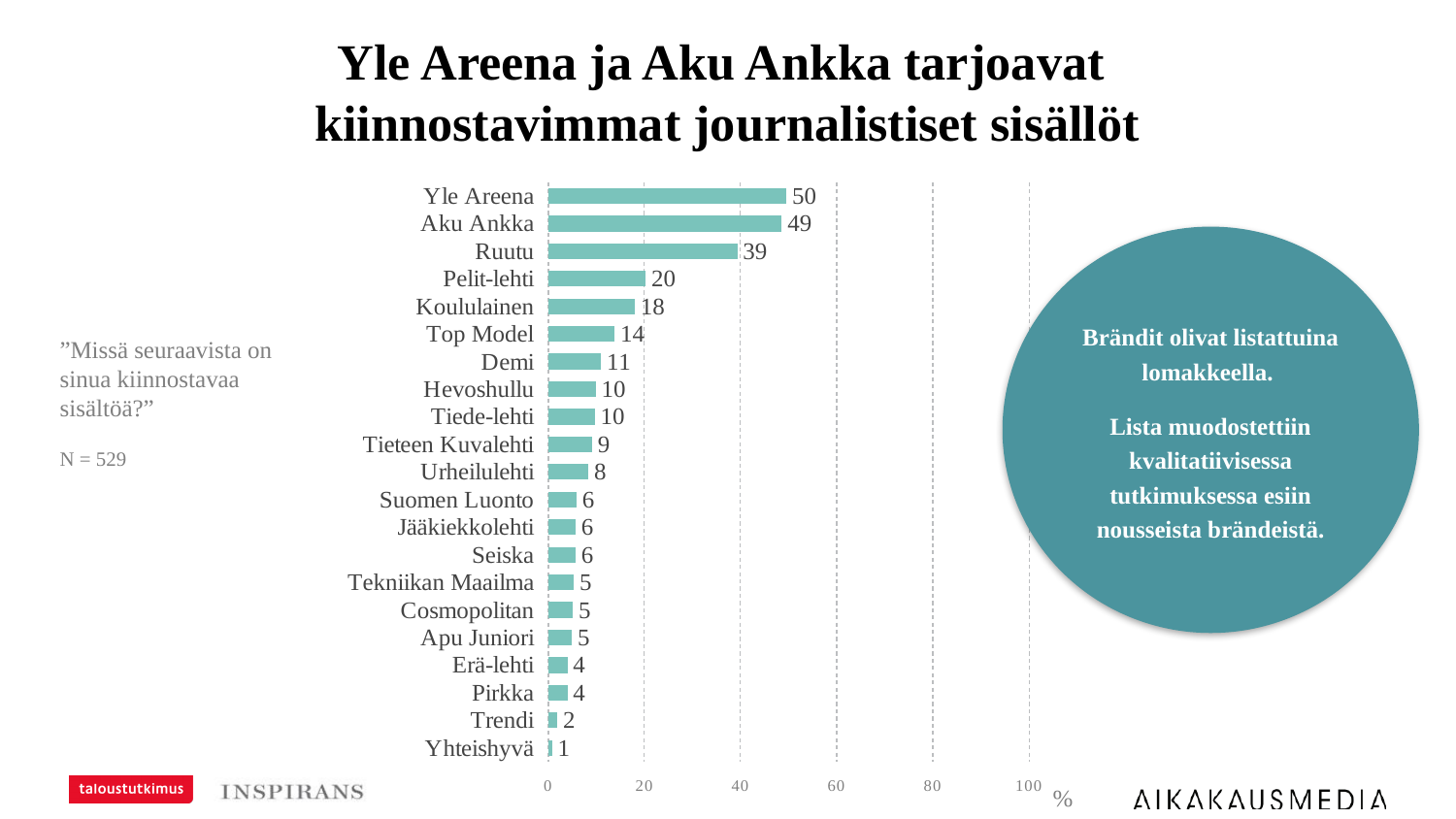
What is the sample size (N) stated on the slide? 529 Which has a larger value, Demi or Urheilulehti? Demi What value is shown for Ruutu? 39 Is the value for Aku Ankka greater or less than 40? greater How many categories are shown in the chart? 21 What is the difference between the values for Yle Areena and Ruutu? 11 What kind of chart is shown on the slide? Bar chart What value is shown for Tieteen Kuvalehti? 9 What value is shown for Koululainen? 18 Which category has the highest value? Yle Areena Which category has the lowest value? Yhteishyvä What is the difference between the values for Pelit-lehti and Top Model? 6